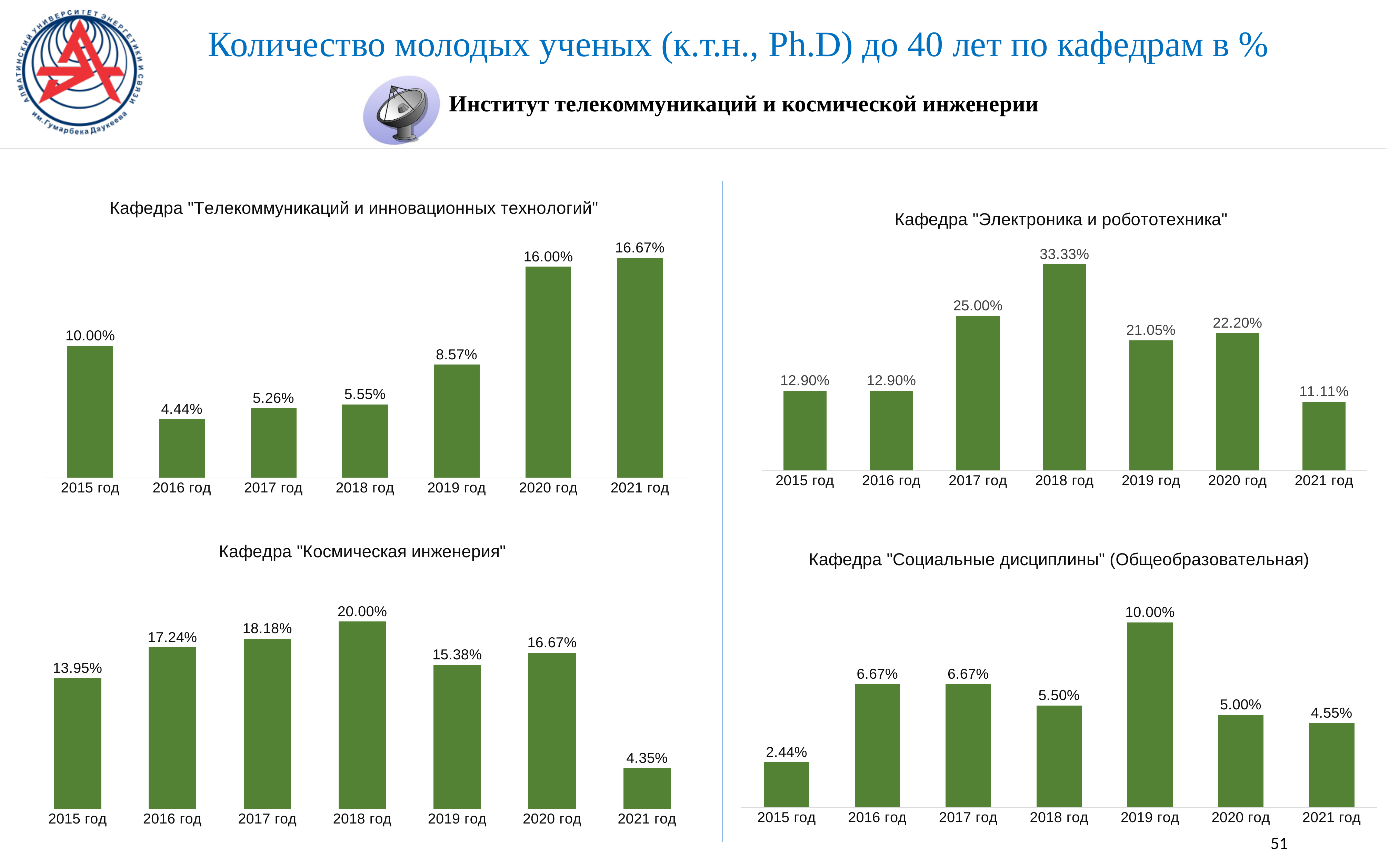
In the chart titled Кафедра "Телекоммуникаций и инновационных технологий" (top-left), which year has the lowest value? 2016 год In the chart titled Кафедра "Космическая инженерия" (bottom-left), what is the difference between the values for 2020 год and 2019 год? 1.29% In the chart titled Кафедра "Социальные дисциплины" (Общеобразовательная) (bottom-right), what is the value for 2015 год? 2.44% In the chart titled Кафедра "Электроника и робототехника" (top-right), which is larger, the value for 2017 год or the value for 2021 год? 2017 год In the chart titled Кафедра "Электроника и робототехника" (top-right), which year has the highest value? 2018 год In the chart titled Кафедра "Электроника и робототехника" (top-right), what is the value for 2020 год? 22.20% In the chart titled Кафедра "Космическая инженерия" (bottom-left), what is the value for 2018 год? 20.00% In the chart titled Кафедра "Телекоммуникаций и инновационных технологий" (top-left), what is the value for 2019 год? 8.57% What kind of chart is the chart titled Кафедра "Социальные дисциплины" (Общеобразовательная) (bottom-right)? Bar chart In the chart titled Кафедра "Социальные дисциплины" (Общеобразовательная) (bottom-right), how many years are shown on the x axis? 7 In the chart titled Кафедра "Космическая инженерия" (bottom-left), which year has the lowest value? 2021 год In the chart titled Кафедра "Телекоммуникаций и инновационных технологий" (top-left), what is the difference between the values for 2021 год and 2015 год? 6.67%